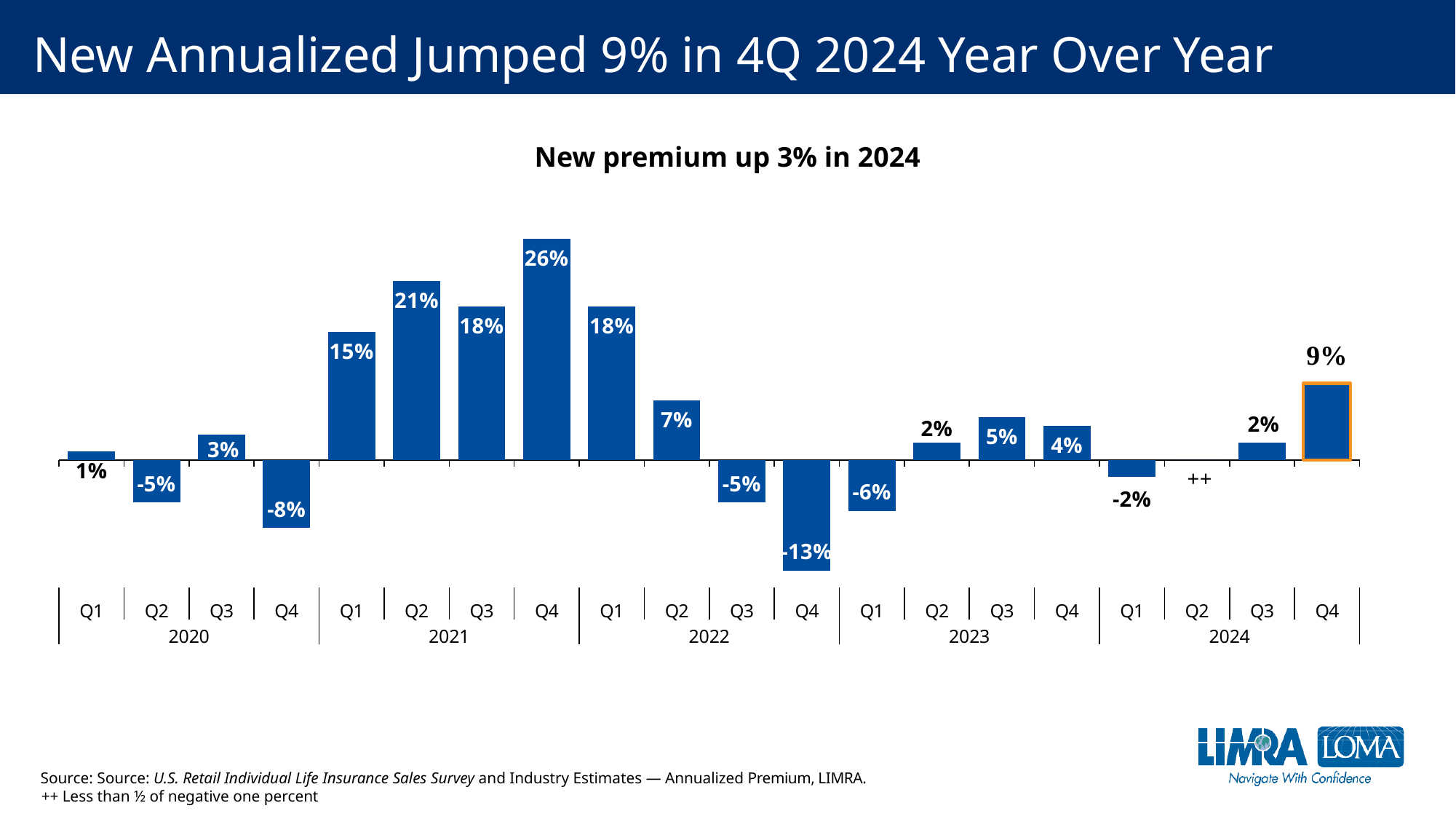
Do the values rise or fall from Q1 2021 to Q2 2021? Rise What is the subtitle shown above the chart? New premium up 3% in 2024 What is the difference between the values for Q4 2021 and Q4 2024? 17% What is the value for Q1 2024? -2% How many quarters are shown on the x axis? 20 What is the value for Q4 2024? 9% What is the value for Q4 2021? 26% Which is larger, the value for Q2 2021 or the value for Q1 2022? Q2 2021 What kind of chart is shown on the slide? Bar chart Which quarter has the lowest value? Q4 2022 What is the value for Q4 2022? -13% Which quarter has the highest value? Q4 2021